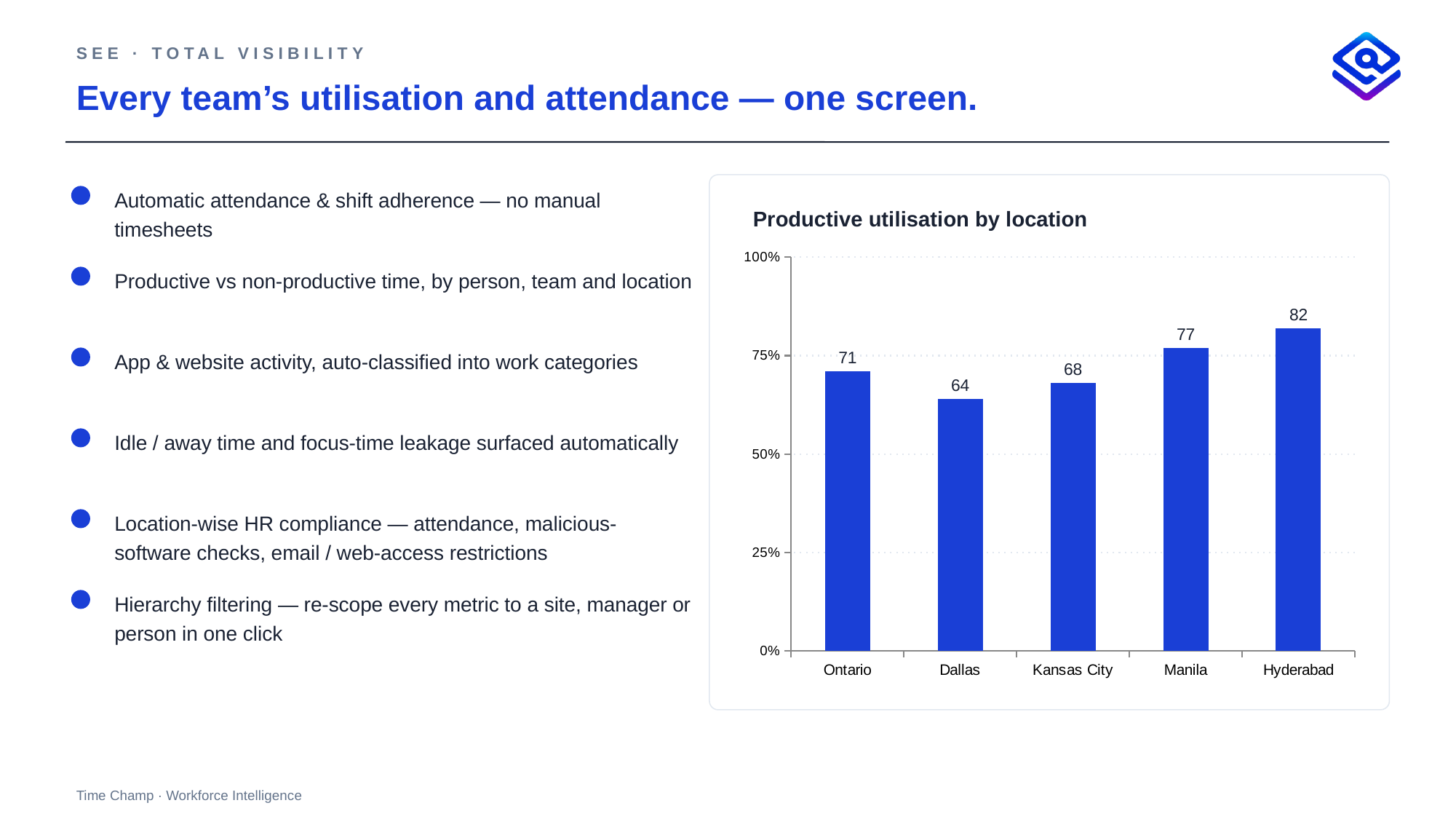
What kind of chart is shown on the slide? Bar chart How many locations are shown in the chart? 5 Is the value for Dallas greater or less than 75%? less What is the difference between the values for Manila and Kansas City? 9 What is the title of the chart? Productive utilisation by location What is the productive utilisation value for Dallas? 64 What is the productive utilisation value for Manila? 77 Which location has the lowest productive utilisation? Dallas Which location has the highest productive utilisation? Hyderabad What is the difference between the values for Hyderabad and Dallas? 18 What is the productive utilisation value for Ontario? 71 Which has a higher productive utilisation, Ontario or Kansas City? Ontario